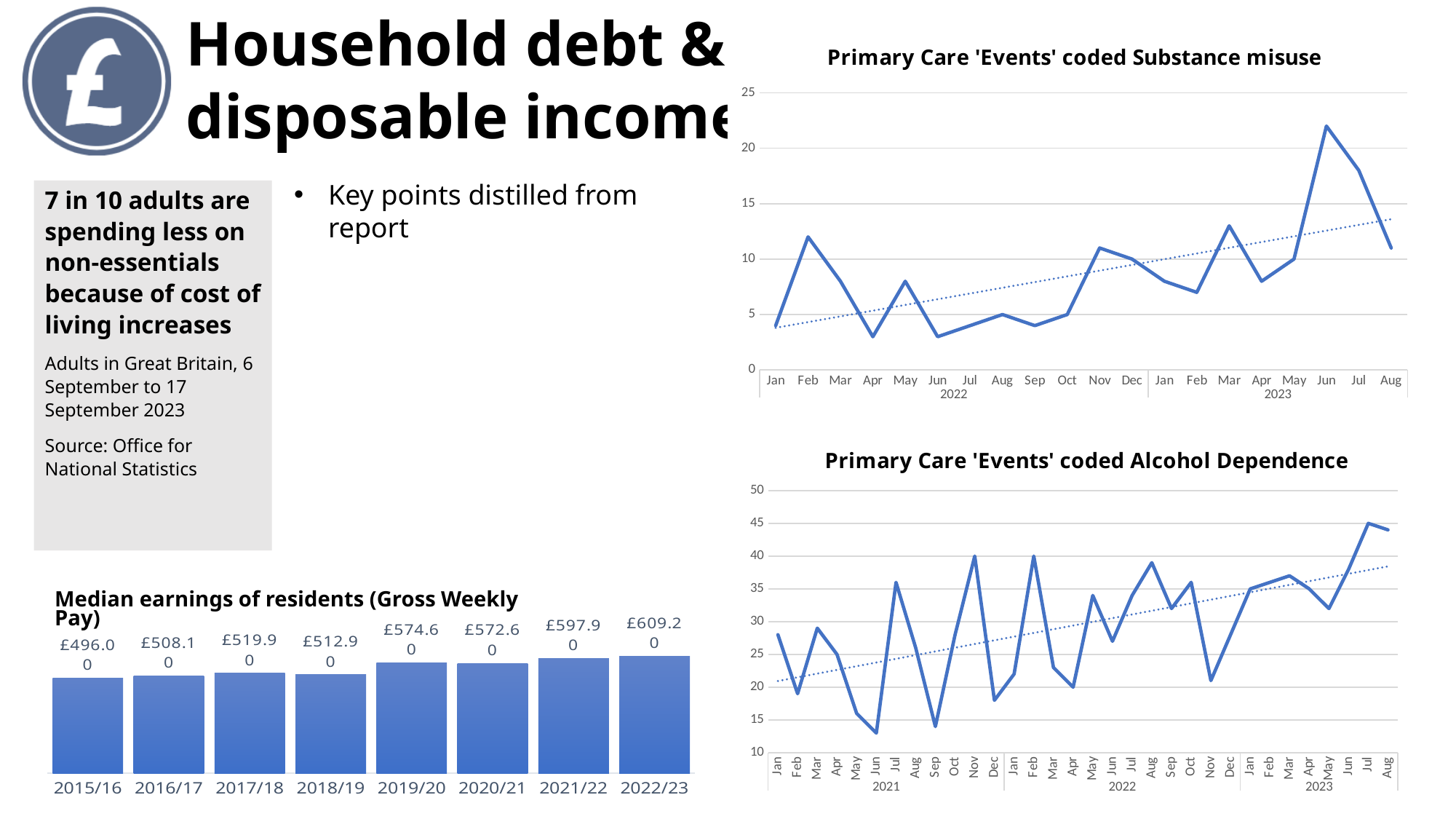
In the 'Primary Care 'Events' coded Substance misuse' chart, is the value for Jun 2023 greater or less than 20? greater In the 'Median earnings of residents (Gross Weekly Pay)' chart, what is the difference between the 2022/23 and 2015/16 values? £113.20 How many years are shown in the 'Median earnings of residents (Gross Weekly Pay)' chart? 8 In the 'Median earnings of residents (Gross Weekly Pay)' chart, which year has the lowest median earnings? 2015/16 In the 'Median earnings of residents (Gross Weekly Pay)' chart, which year has the highest median earnings? 2022/23 In the 'Median earnings of residents (Gross Weekly Pay)' chart, what is the value for 2022/23? £609.20 In the 'Primary Care 'Events' coded Substance misuse' chart, which month has the highest value? Jun 2023 In the 'Median earnings of residents (Gross Weekly Pay)' chart, what is the value for 2015/16? £496.00 What kind of chart is 'Median earnings of residents (Gross Weekly Pay)'? Bar chart In the 'Median earnings of residents (Gross Weekly Pay)' chart, which is larger: the value for 2017/18 or 2018/19? 2017/18 What kind of chart is 'Primary Care 'Events' coded Substance misuse'? Line chart In the 'Primary Care 'Events' coded Alcohol Dependence' chart, is the value for Jun 2021 greater or less than 15? less